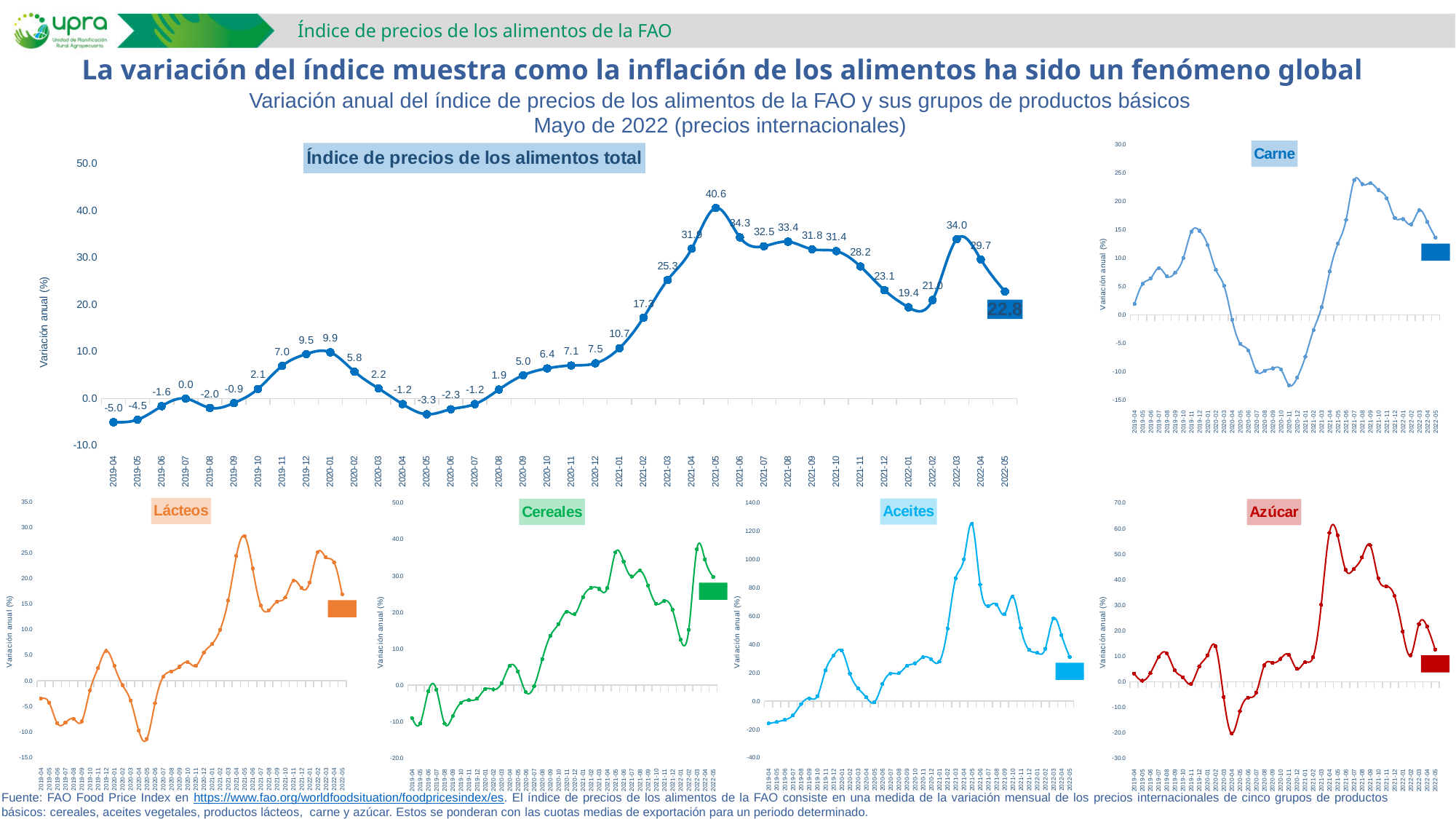
How many smaller charts for product groups (besides the total index chart) are shown on the slide? 5 In the 'Carne' chart, is the peak value in 2021 greater or less than 20.0? greater In the chart 'Índice de precios de los alimentos total', what is the value for 2021-05? 40.6 In the chart 'Índice de precios de los alimentos total', how many monthly data points are plotted? 38 In the chart 'Índice de precios de los alimentos total', which month has the highest value? 2021-05 In the chart 'Índice de precios de los alimentos total', what is the difference between the values for 2021-05 and 2022-03? 6.6 In the chart 'Índice de precios de los alimentos total', what is the value for 2022-05? 22.8 In the 'Aceites' chart, is the peak value in 2021 greater or less than 100.0? greater In the chart 'Índice de precios de los alimentos total', which is larger, the value for 2022-03 or the value for 2022-04? 2022-03 In the chart 'Índice de precios de los alimentos total', do the values rise or fall from 2021-05 to 2022-01? fall What kind of chart is the 'Índice de precios de los alimentos total' chart? line chart In the chart 'Índice de precios de los alimentos total', which month has the lowest value? 2019-04